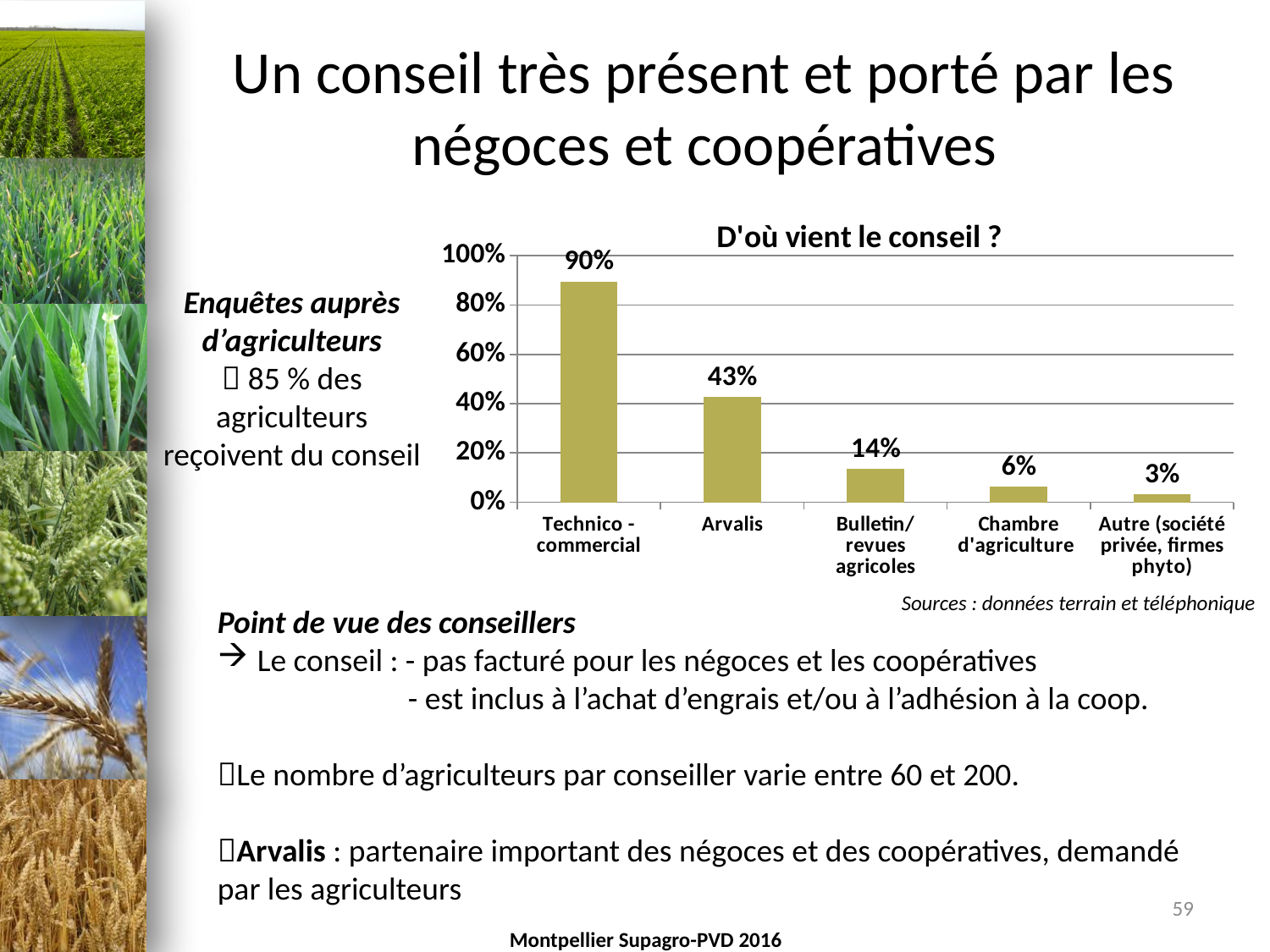
What is the value for Chambre d'agriculture? 6% What is the value for Arvalis? 43% What is the value for Technico - commercial? 90% What is the value for Bulletin/revues agricoles? 14% Which category has the highest value? Technico - commercial What is the title of the chart? D'où vient le conseil ? How many categories are shown in the chart? 5 What kind of chart is shown on the slide? Bar chart Do the values rise or fall from left to right along the x axis? Fall Which is larger, the value for Bulletin/revues agricoles or Chambre d'agriculture? Bulletin/revues agricoles Which category has the lowest value? Autre (société privée, firmes phyto) What is the difference between the values for Technico - commercial and Arvalis? 47%